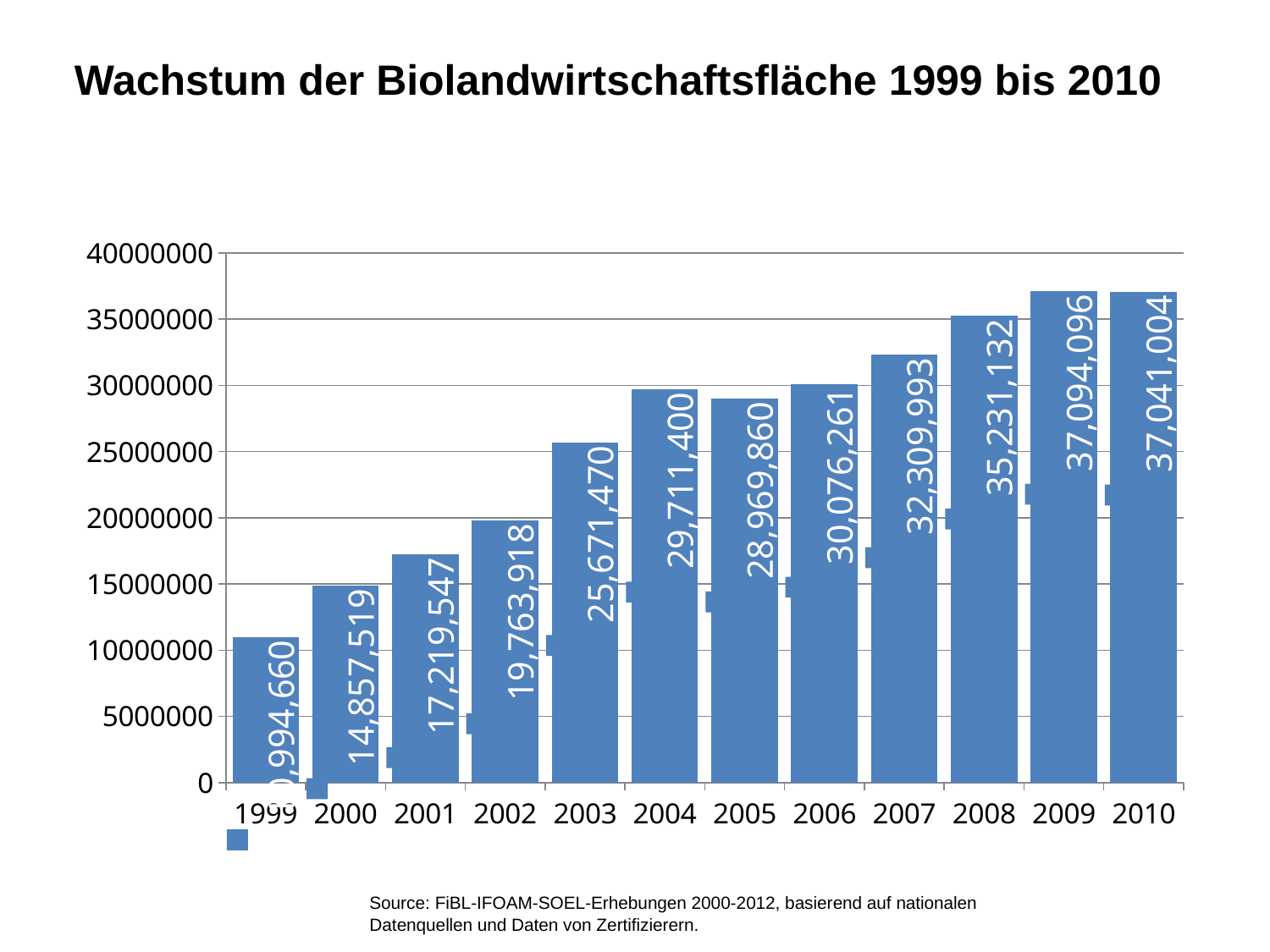
How many years are shown on the x axis? 12 Which is larger, the value for 2009 or the value for 2010? 2009 What is the value shown for 2002? 19,763,918 What is the difference between the values for 2008 and 2007? 2,921,139 Which year has the highest value? 2009 What kind of chart is shown on the slide? bar chart What is the value shown for 2005? 28,969,860 Which year has the lowest value? 1999 What is the value shown for 2009? 37,094,096 By how much does the value for 2004 exceed the value for 2005? 741,540 Do the values generally rise or fall from 1999 to 2010? rise Is the value for 1999 greater or less than 15000000? less